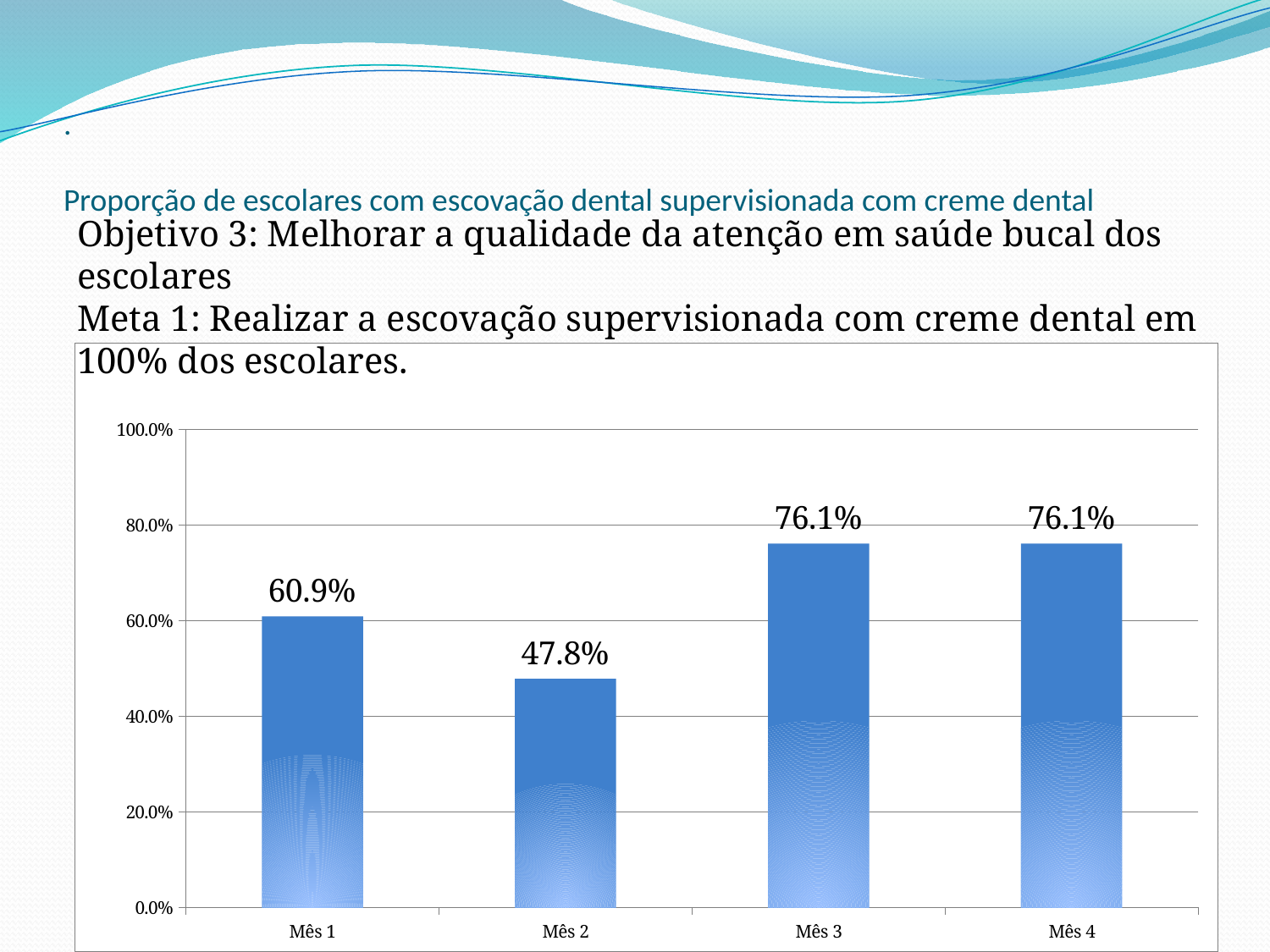
Which is larger, the value for Mês 1 or the value for Mês 2? Mês 1 What is the value for Mês 3? 76.1% What is the value for Mês 1? 60.9% What is the difference between the values for Mês 1 and Mês 2? 13.1% Which months share the highest value? Mês 3 and Mês 4 What is the value for Mês 4? 76.1% What is the value for Mês 2? 47.8% What is the difference between the values for Mês 3 and Mês 2? 28.3% What kind of chart is shown on the slide? bar chart Is the value for Mês 2 greater or less than 60.0%? less How many months are shown on the x axis? 4 Which month has the lowest value? Mês 2